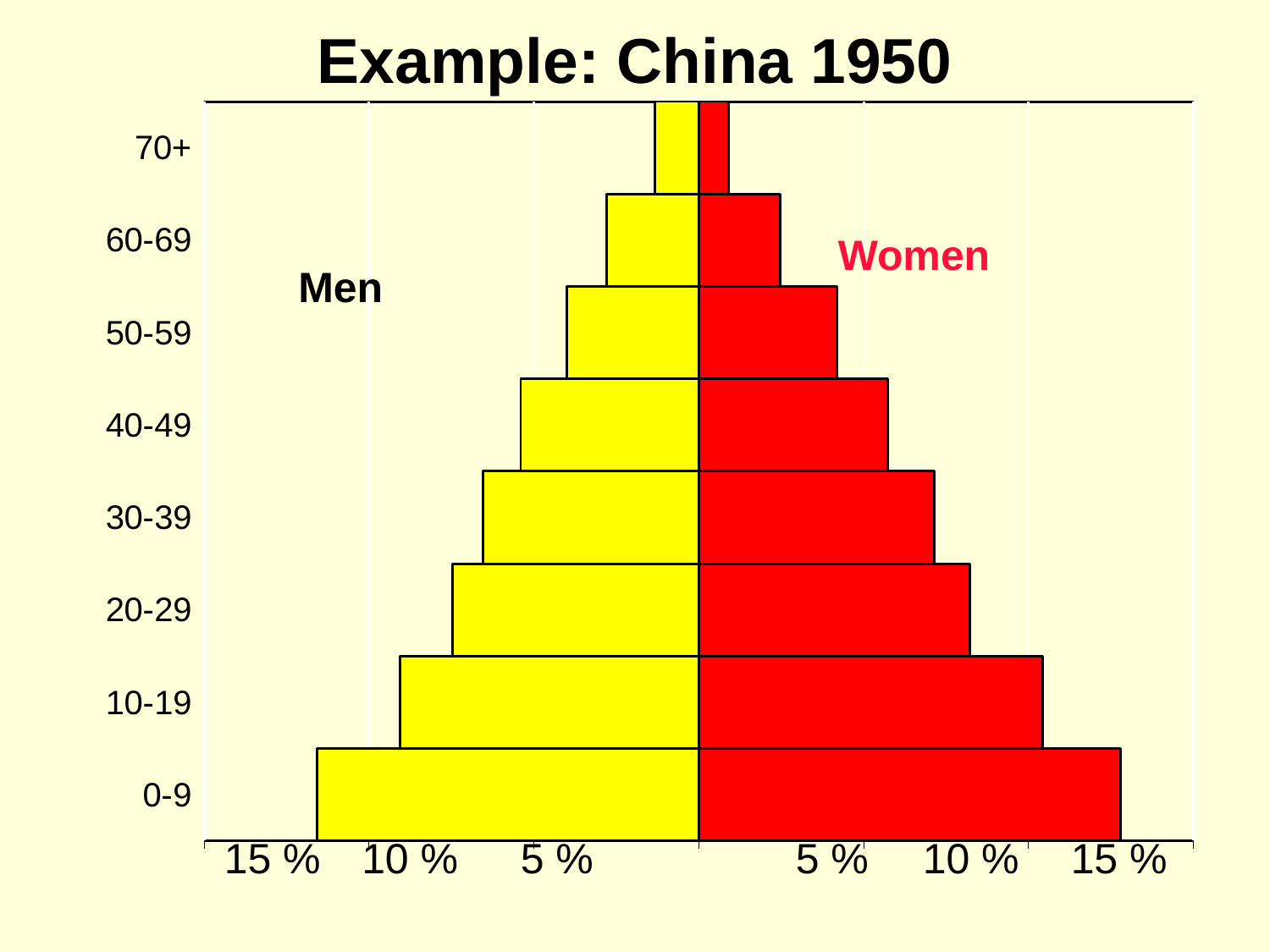
Which is larger: the Men bar for 0-9 or the Men bar for 10-19? 0-9 Do the bar lengths increase or decrease as the age groups get older? decrease Is the value for Men aged 10-19 greater or less than 10 %? less Is the value for Men aged 0-9 greater or less than 10 %? greater Which age group has the smallest share for Women? 70+ Which colour represents Women on the chart? Red Is the value for Men aged 50-59 greater or less than 5 %? less Which age group has the largest share for Men? 0-9 What kind of chart is shown on the slide? Bar chart (population pyramid) What is the title of the chart? Example: China 1950 How many age groups are shown on the chart? 8